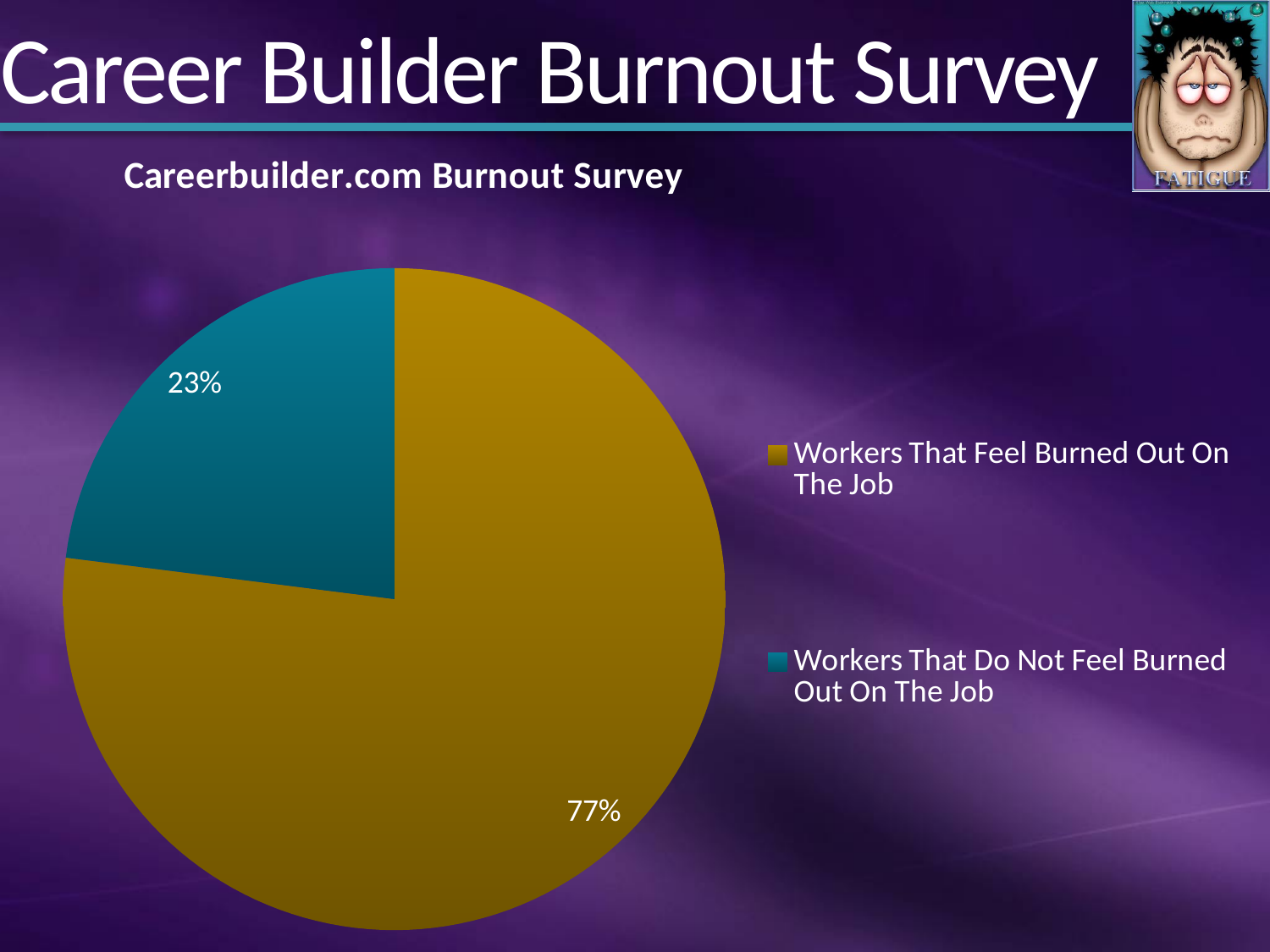
Which category has the largest share of the pie? Workers That Feel Burned Out On The Job What colour is the slice for workers that do not feel burned out on the job? teal Which is larger: the share of workers that feel burned out or the share that do not feel burned out? Workers That Feel Burned Out On The Job What percentage of workers do not feel burned out on the job? 23% How many slices does the pie chart have? 2 How many entries does the legend list? 2 What percentage of workers feel burned out on the job? 77% What is the chart's title? Careerbuilder.com Burnout Survey What is the difference in percentage points between workers that feel burned out and workers that do not feel burned out? 54 What share of the pie is taken by workers that feel burned out on the job? 77% Which category has the smallest share of the pie? Workers That Do Not Feel Burned Out On The Job What type of chart is shown on the slide? pie chart